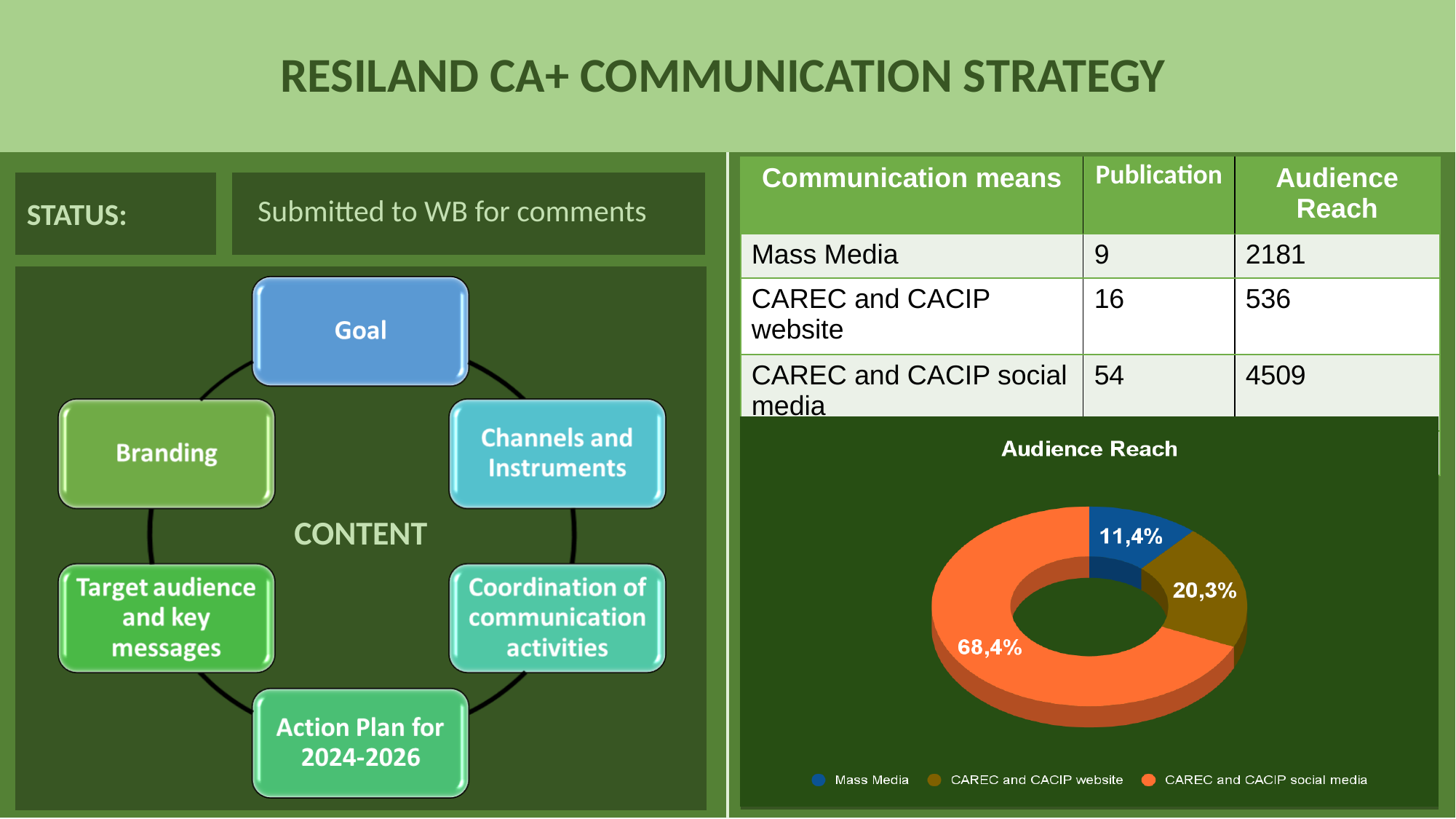
Which category has the largest slice in the "Audience Reach" chart? CAREC and CACIP social media What share of the "Audience Reach" pie does Mass Media have? 11,4% In the "Audience Reach" chart, what is the difference in percentage points between CAREC and CACIP social media and CAREC and CACIP website? 48,1 What share of the "Audience Reach" pie does CAREC and CACIP website have? 20,3% How many entries does the legend of the "Audience Reach" chart list? 3 What share of the "Audience Reach" pie does CAREC and CACIP social media have? 68,4% Which category has the smallest slice in the "Audience Reach" chart? Mass Media How many slices does the "Audience Reach" chart have? 3 What is the title of the chart on the slide? Audience Reach What colour is the CAREC and CACIP social media slice in the "Audience Reach" chart? Orange In the "Audience Reach" chart, which is larger: Mass Media or CAREC and CACIP website? CAREC and CACIP website What kind of chart is the "Audience Reach" chart? Pie chart